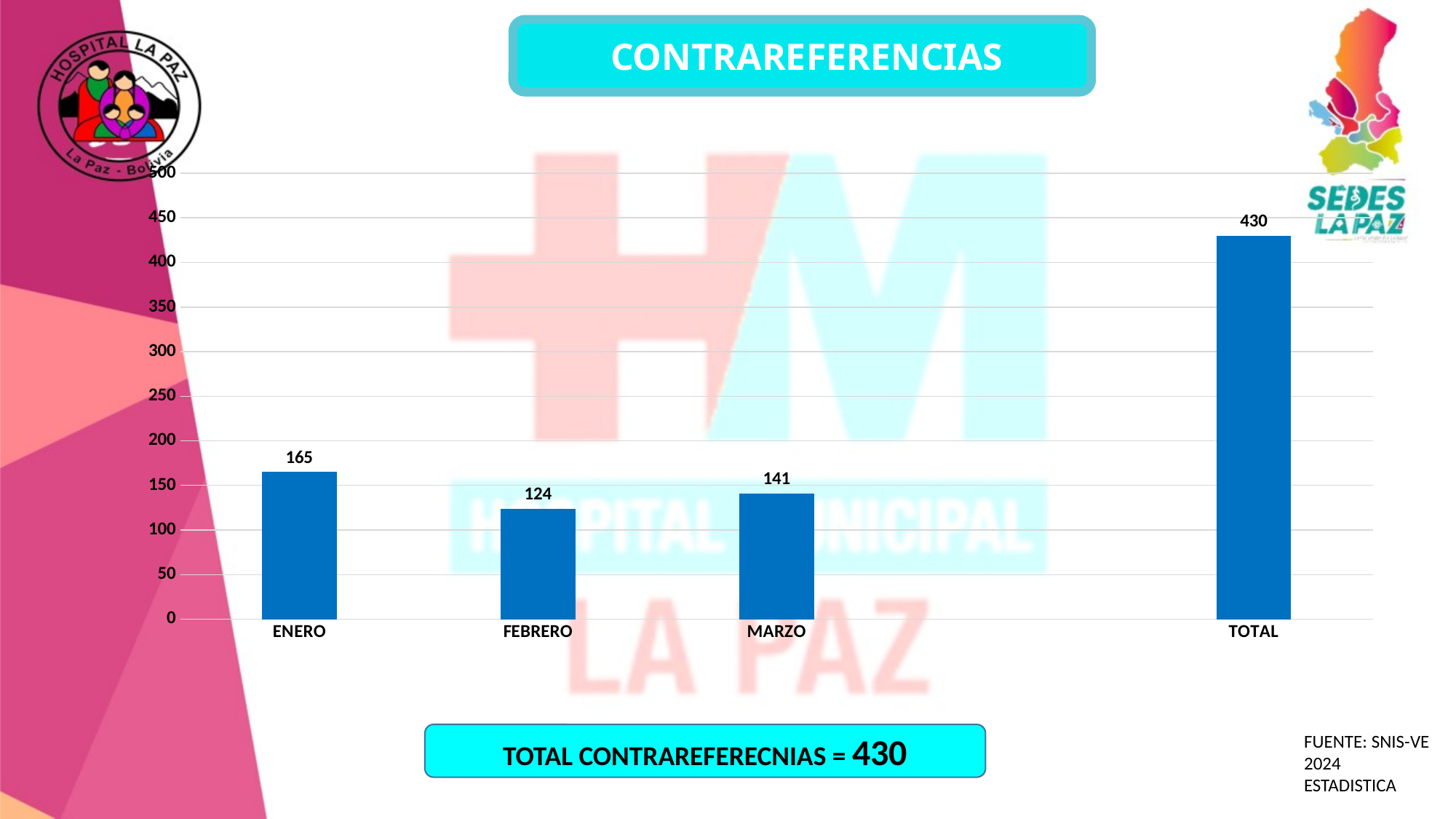
What is the value for ENERO? 165 Among the months ENERO, FEBRERO and MARZO, which has the highest value? ENERO What is the value for TOTAL? 430 What is the difference between the values for ENERO and FEBRERO? 41 What is the value for MARZO? 141 Which category has the lowest value? FEBRERO Which is larger, the value for MARZO or the value for FEBRERO? MARZO What kind of chart is shown on the slide? bar chart What is the value for FEBRERO? 124 What is the title of the chart? CONTRAREFERENCIAS How many bars are shown in the chart? 4 Is the value for MARZO greater or less than 150? less